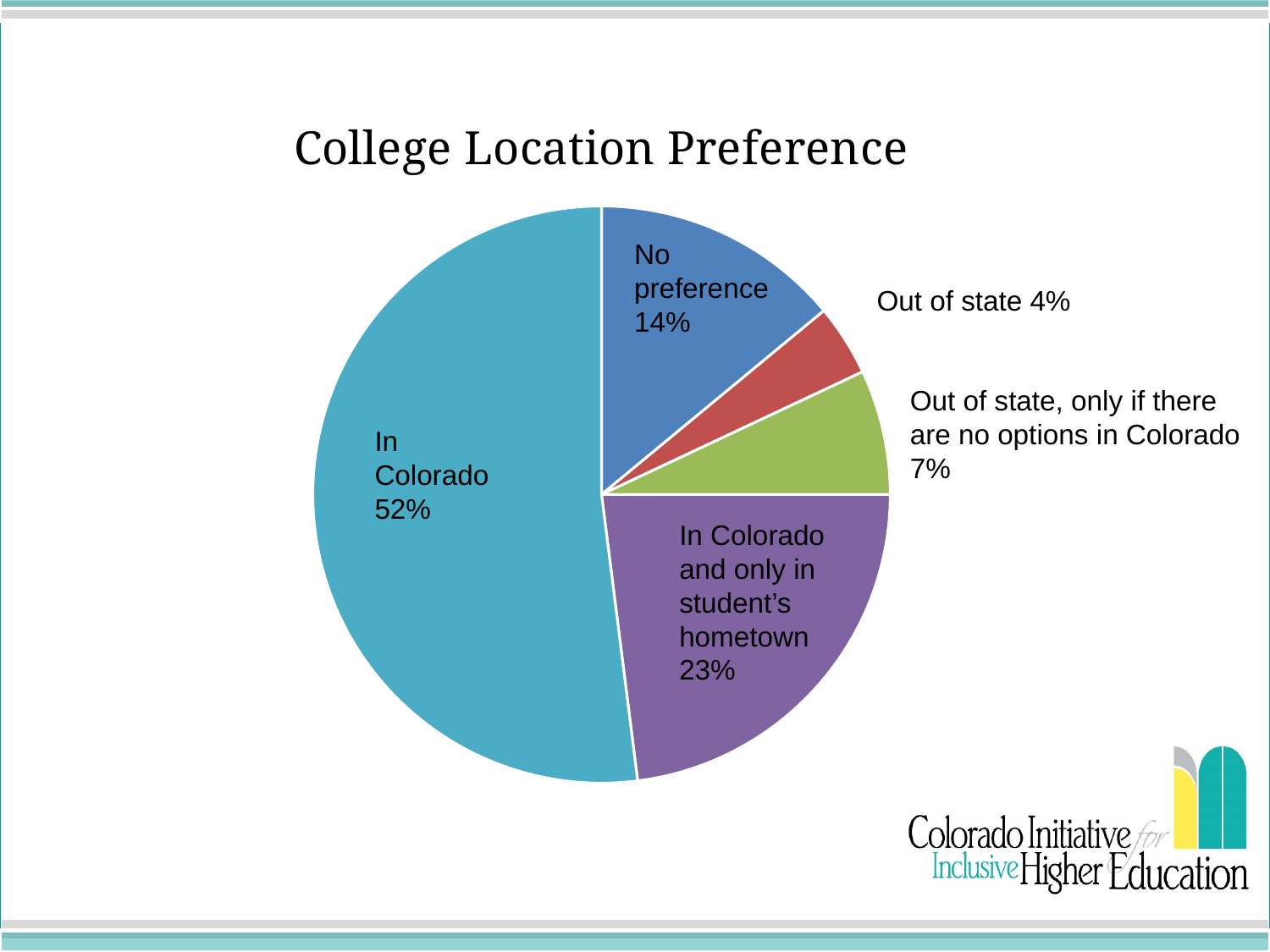
What percentage is shown for "Out of state"? 4% Which is larger, the share for "No preference" or the share for "Out of state, only if there are no options in Colorado"? No preference What is the difference in percentage points between "In Colorado" and "In Colorado and only in student's hometown"? 29 Which category has the largest slice of the pie? In Colorado What is the title of the chart? College Location Preference What percentage is shown for "No preference"? 14% Which category has the smallest slice of the pie? Out of state How many slices does the pie chart have? 5 What kind of chart is shown on the slide? pie chart What percentage is shown for "In Colorado and only in student's hometown"? 23% What share of the pie is labelled "In Colorado"? 52% What percentage is shown for "Out of state, only if there are no options in Colorado"? 7%